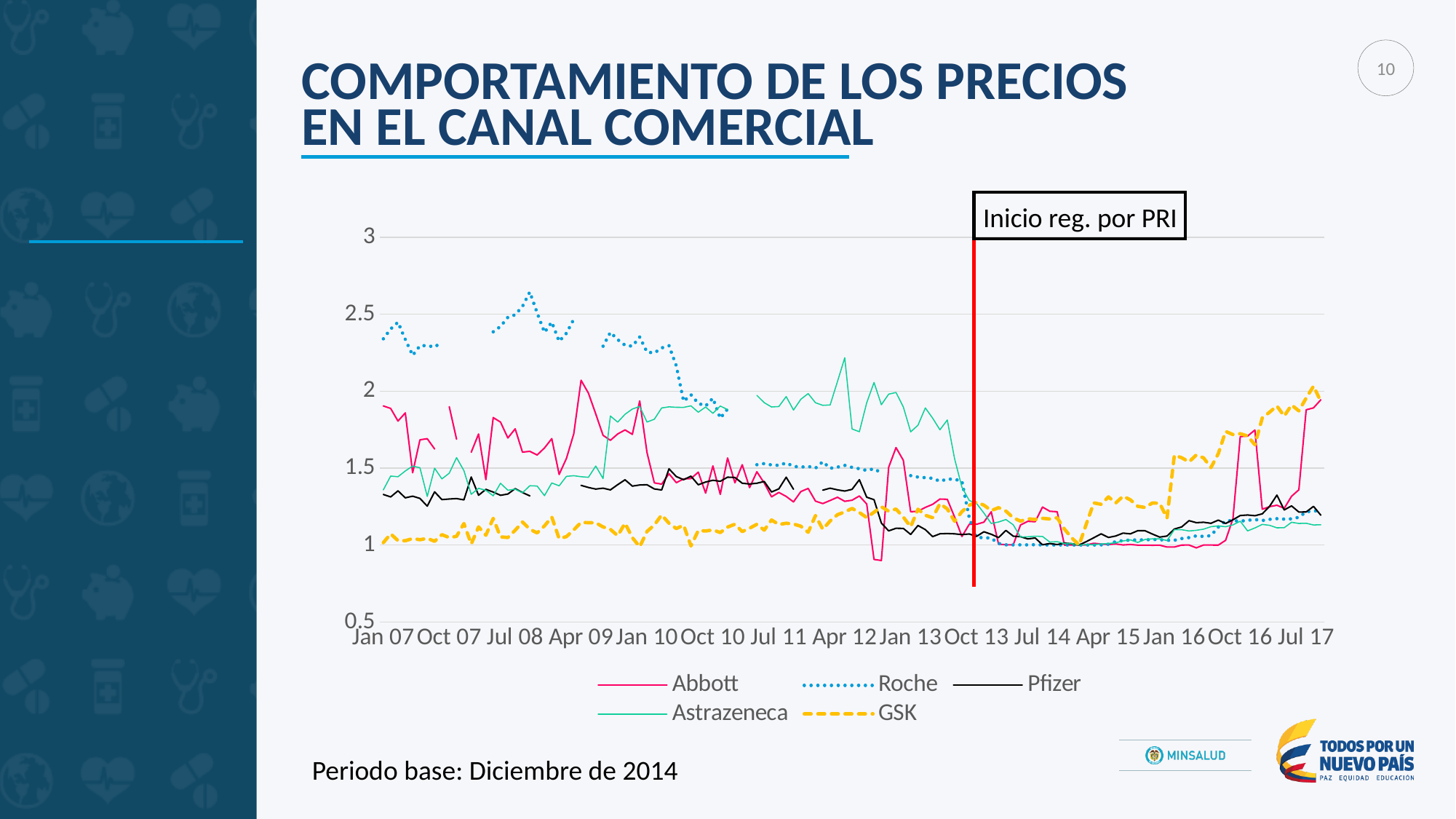
What kind of chart is shown on the slide? line chart Is the value for GSK at Jan 07 greater or less than 1.5? less At Jul 17, which series is larger, GSK or Pfizer? GSK Which series has the lowest value at Jan 07? GSK Which series has the highest value at Jan 07? Roche Is the value for Pfizer at Jul 14 greater or less than 1.5? less Is the value for Roche at Jan 07 greater or less than 2? greater What text is in the boxed annotation above the red vertical line? Inicio reg. por PRI Does the Roche series rise or fall between Jan 07 and Jul 14? fall How many series does the legend list? 5 Does the GSK series rise or fall between Apr 15 and Jul 17? rise